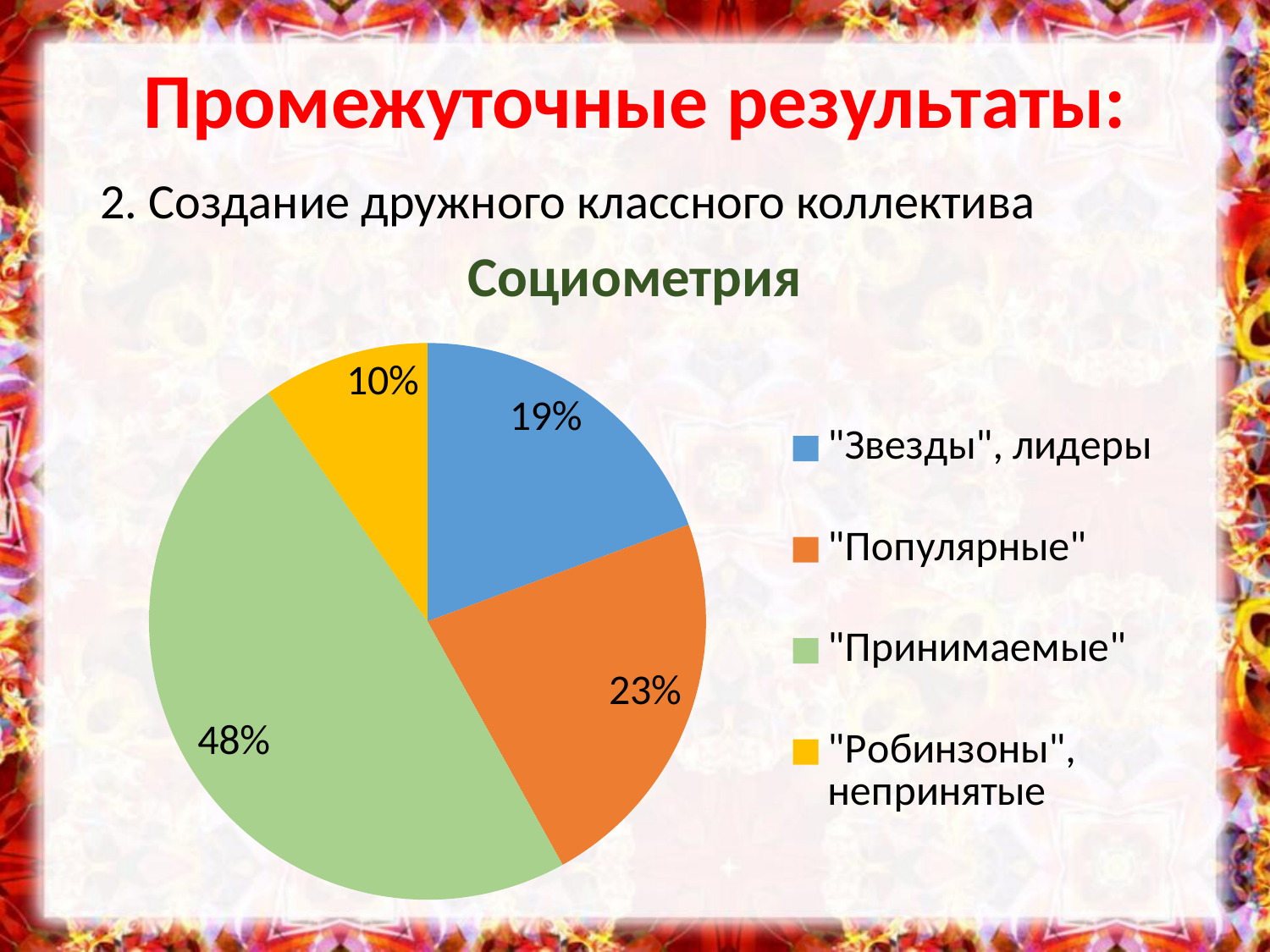
What is the difference in percentage points between "Принимаемые" and "Популярные"? 25 What is the title of the chart? Социометрия What kind of chart is shown on the slide? pie chart What share of the pie is labelled "Звезды", лидеры? 19% Which category has the smallest slice of the pie? "Робинзоны", непринятые Which category has the largest slice of the pie? "Принимаемые" What share of the pie is labelled "Робинзоны", непринятые? 10% How many slices does the pie chart have? 4 What share of the pie is labelled "Принимаемые"? 48% Which is larger, the slice for "Популярные" or the slice for "Звезды", лидеры? "Популярные" What share of the pie is labelled "Популярные"? 23% What colour is the slice for "Принимаемые"? green